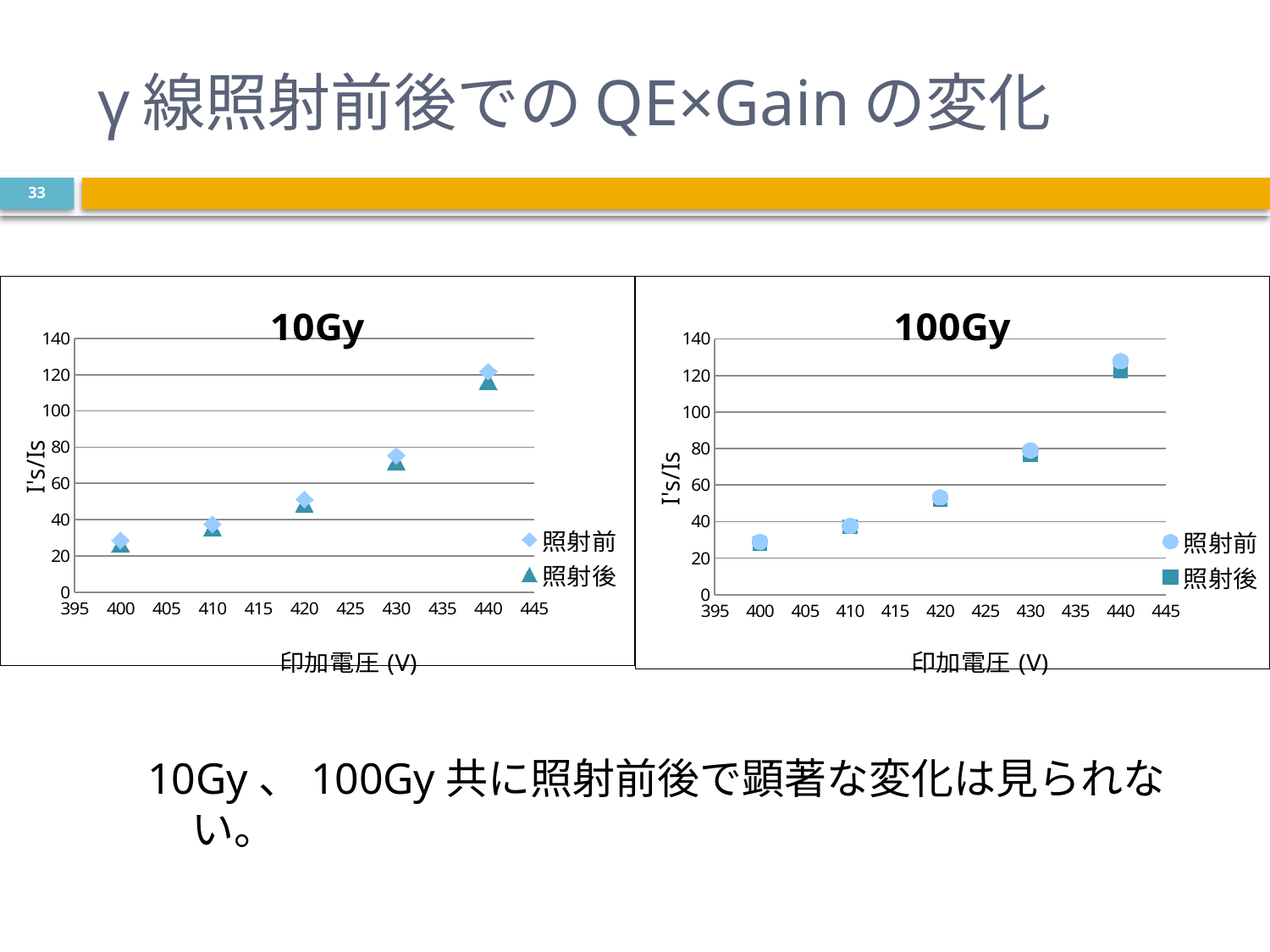
In the 10Gy chart, how many data points are plotted for the 照射前 series? 5 In the 100Gy chart, is the 照射前 value at 440 V greater or less than 120? greater What are the two legend entries in the 10Gy chart? 照射前, 照射後 In the 10Gy chart, is the 照射前 value at 440 V greater or less than 100? greater What is the y-axis label of the 100Gy chart? I's/Is In the 100Gy chart, is the 照射後 value at 420 V greater or less than 60? less How many series does the legend of the 100Gy chart list? 2 What kind of chart is the 10Gy chart? scatter chart In the 10Gy chart, at which applied voltage is the 照射前 value highest? 440 In the 100Gy chart, do the 照射前 values rise or fall as the applied voltage increases? rise In the 100Gy chart, at which applied voltage is the 照射後 value lowest? 400